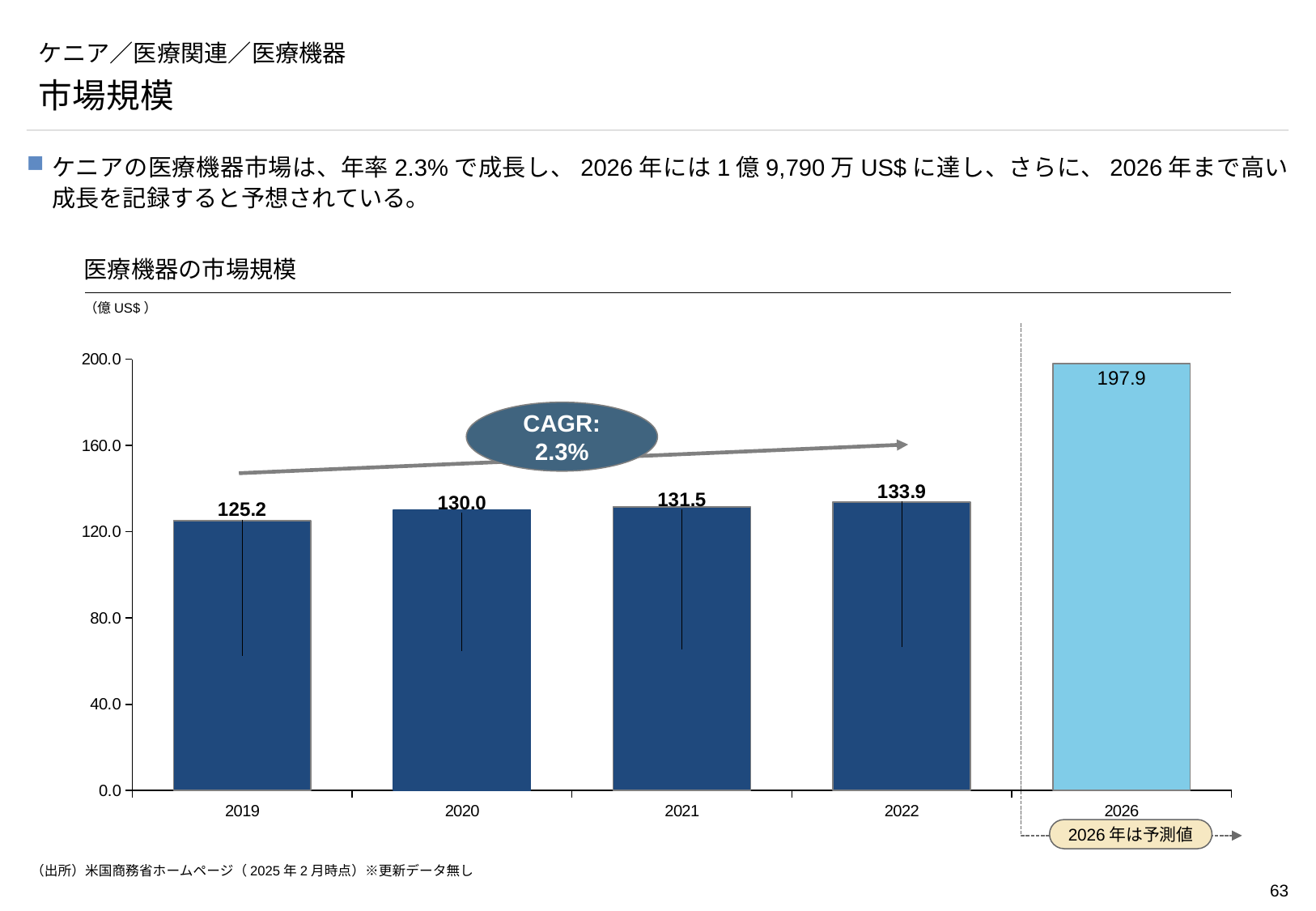
What kind of chart is the 医療機器の市場規模 chart? bar chart What CAGR is shown in the 医療機器の市場規模 chart? 2.3% What is the difference between the 2020 value and the 2019 value in the 医療機器の市場規模 chart? 4.8 Which year has the highest value in the 医療機器の市場規模 chart? 2026 Which is larger in the 医療機器の市場規模 chart, the value for 2021 or the value for 2022? 2022 What is the forecast value for 2026 in the 医療機器の市場規模 chart? 197.9 How many years are plotted in the 医療機器の市場規模 chart? 5 Which year has the lowest value in the 医療機器の市場規模 chart? 2019 Is the value for 2026 greater or less than 160.0 in the 医療機器の市場規模 chart? greater What is the value for 2022 in the 医療機器の市場規模 chart? 133.9 What is the value for 2019 in the 医療機器の市場規模 chart? 125.2 What is the difference between the 2026 value and the 2022 value in the 医療機器の市場規模 chart? 64.0